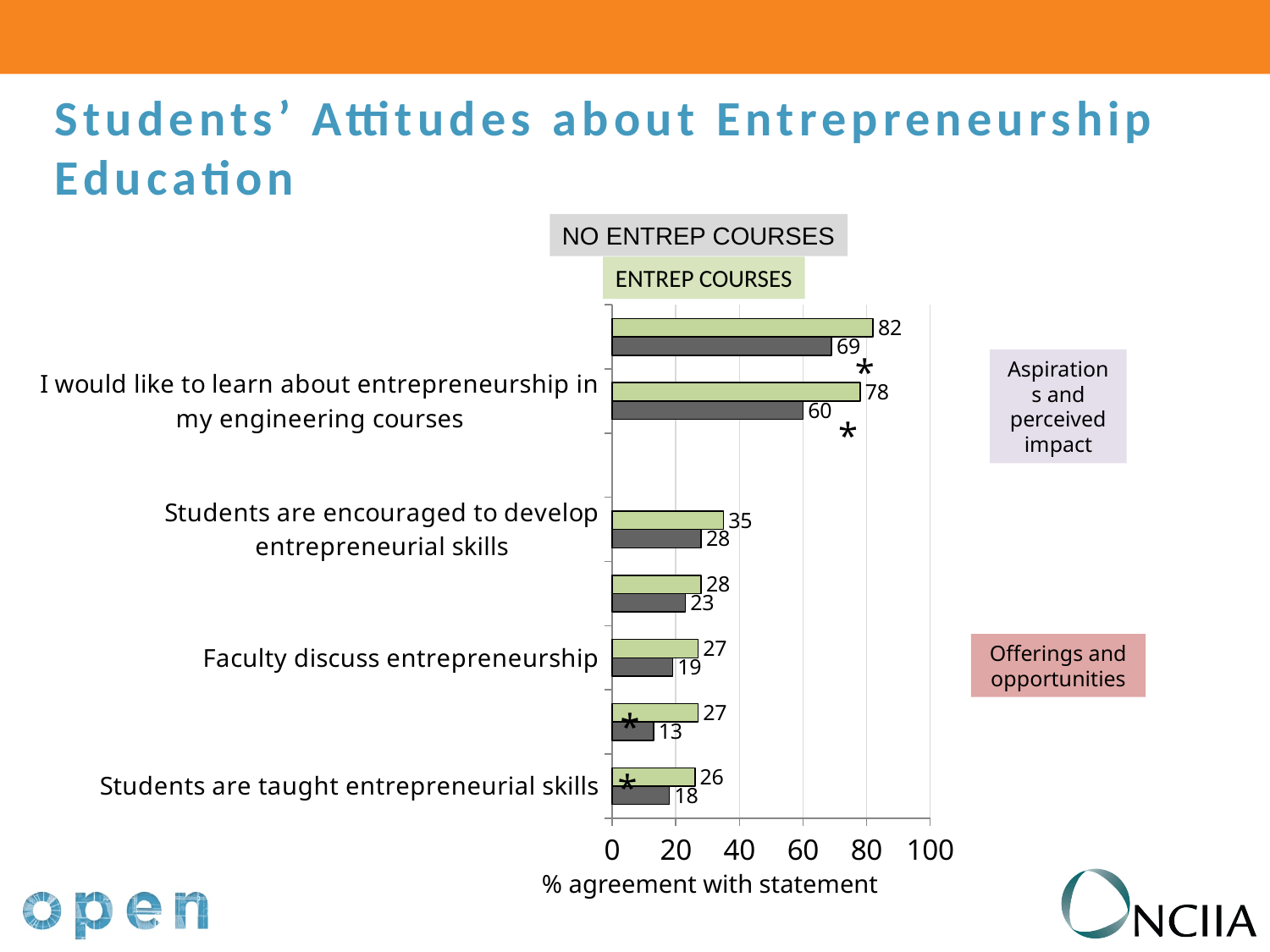
What kind of chart is shown on the slide? bar chart What is the ENTREP COURSES value for "Students are taught entrepreneurial skills"? 26 What is the ENTREP COURSES value for "Faculty discuss entrepreneurship"? 27 What is the NO ENTREP COURSES value for "Students are encouraged to develop entrepreneurial skills"? 28 What is the highest value labelled on the chart? 82 What is the difference between the ENTREP COURSES and NO ENTREP COURSES values for "Students are taught entrepreneurial skills"? 8 What is the title of the chart's horizontal axis? % agreement with statement What is the difference between the ENTREP COURSES and NO ENTREP COURSES values for "Students are encouraged to develop entrepreneurial skills"? 7 What is the NO ENTREP COURSES value for "Students are taught entrepreneurial skills"? 18 What colour are the ENTREP COURSES bars? green For "Faculty discuss entrepreneurship", which series has the larger value, ENTREP COURSES or NO ENTREP COURSES? ENTREP COURSES How many series does the chart's legend list? 2